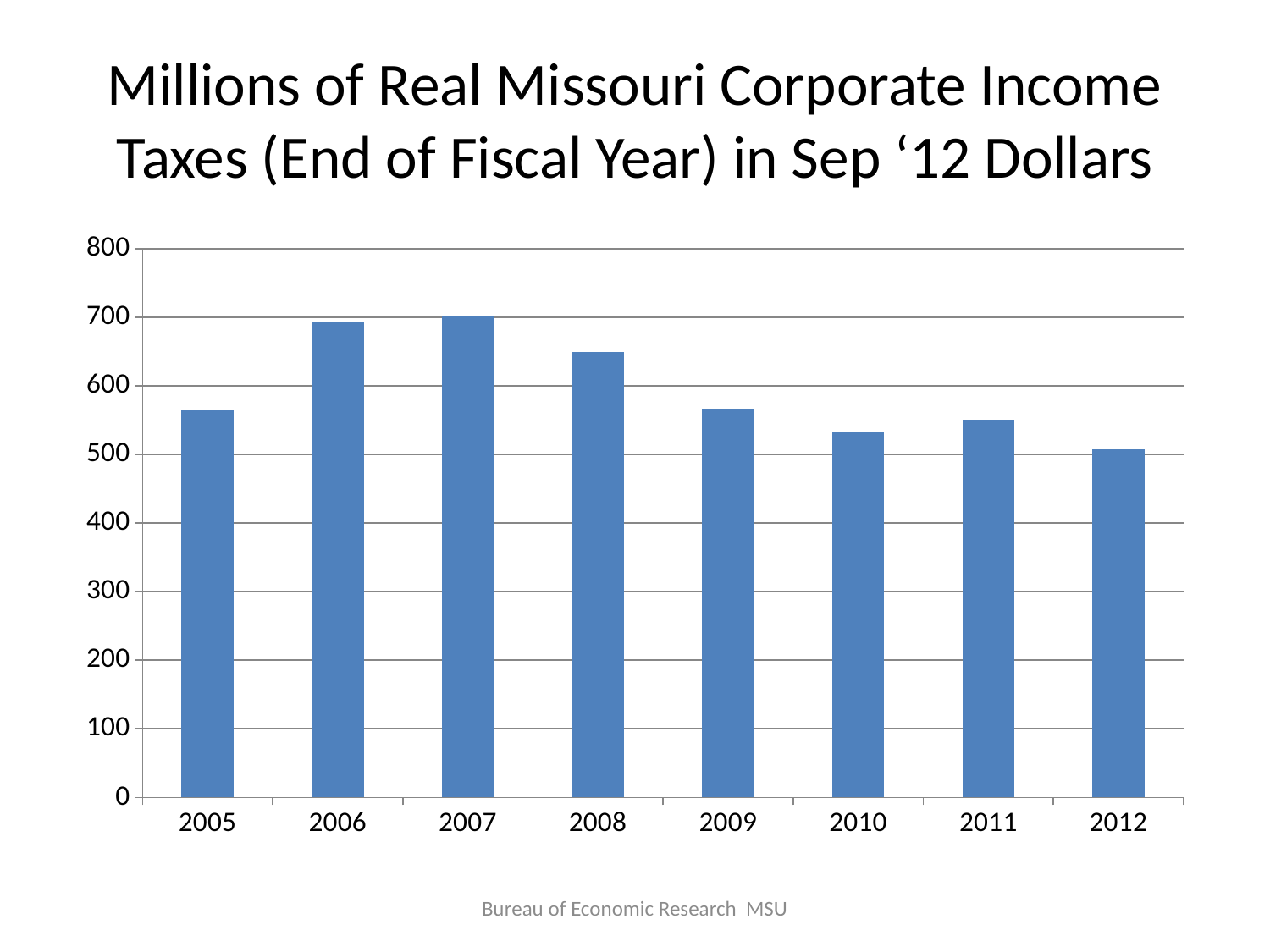
Is the value for 2008 greater or less than 600? greater How many years are shown on the x axis of the chart? 8 Which year has the lowest value in the chart? 2012 Which is larger, the value for 2010 or the value for 2007? 2007 Is the value for 2006 greater or less than 600? greater Is the value for 2009 greater or less than 600? less Do the values rise or fall from 2007 to 2010? fall What kind of chart is shown on the slide? bar chart Which is larger, the value for 2008 or the value for 2009? 2008 What is the title of the chart? Millions of Real Missouri Corporate Income Taxes (End of Fiscal Year) in Sep '12 Dollars